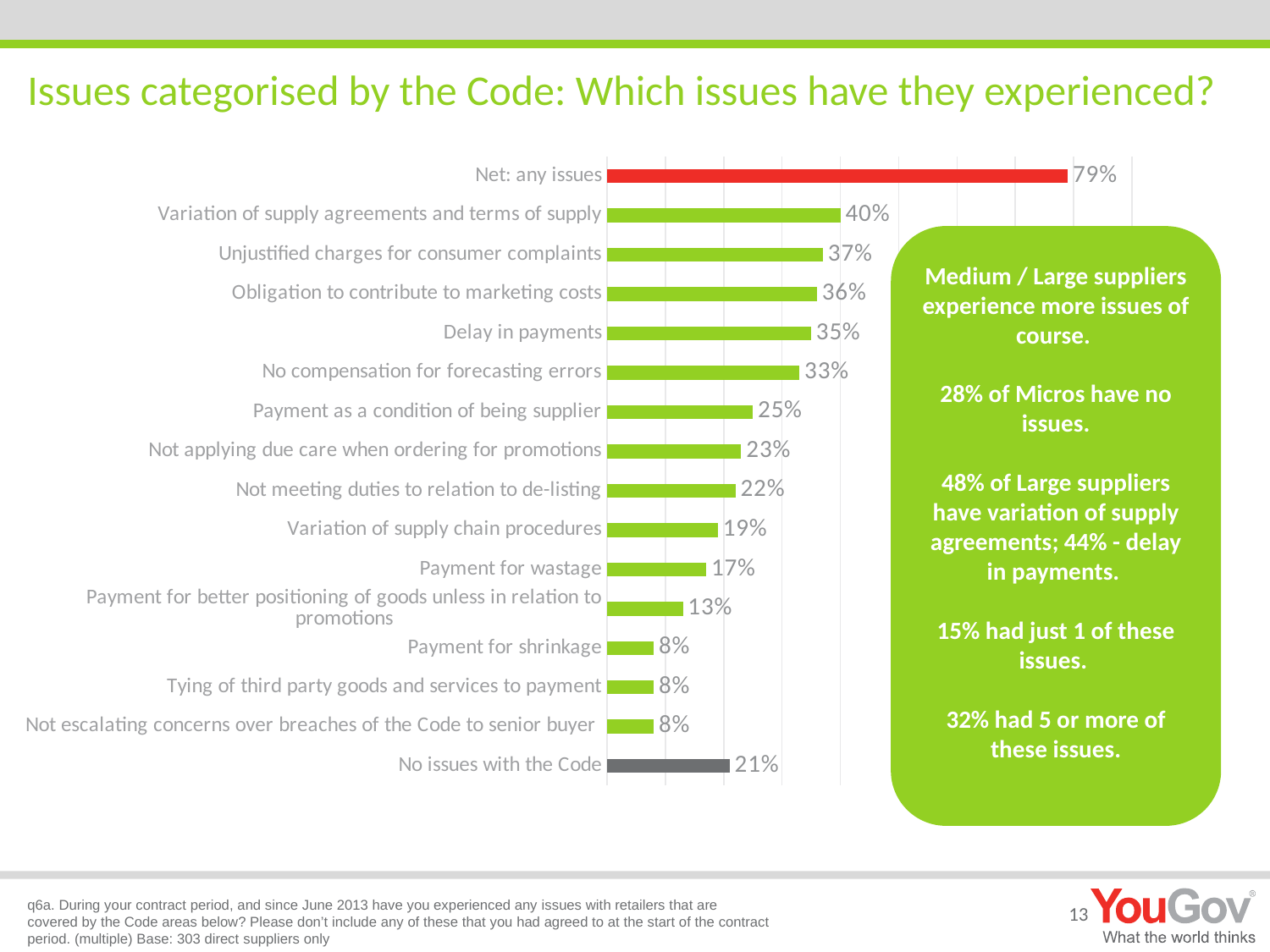
What colour is the bar for 'Net: any issues'? Red What kind of chart is shown on the slide? Bar chart How many bars are shown in the chart? 16 What is the difference between 'Variation of supply agreements and terms of supply' and 'Unjustified charges for consumer complaints'? 3% What is the difference between 'Net: any issues' and 'No issues with the Code'? 58% What percentage experienced 'Delay in payments'? 35% What is the value for 'No issues with the Code'? 21% Which is larger: 'No compensation for forecasting errors' or 'Payment as a condition of being supplier'? No compensation for forecasting errors Excluding the 'Net: any issues' bar, which issue has the highest value? Variation of supply agreements and terms of supply What is the value for 'Payment for wastage'? 17% What is the value for 'Net: any issues'? 79% How many categories share the lowest value of 8%? 3